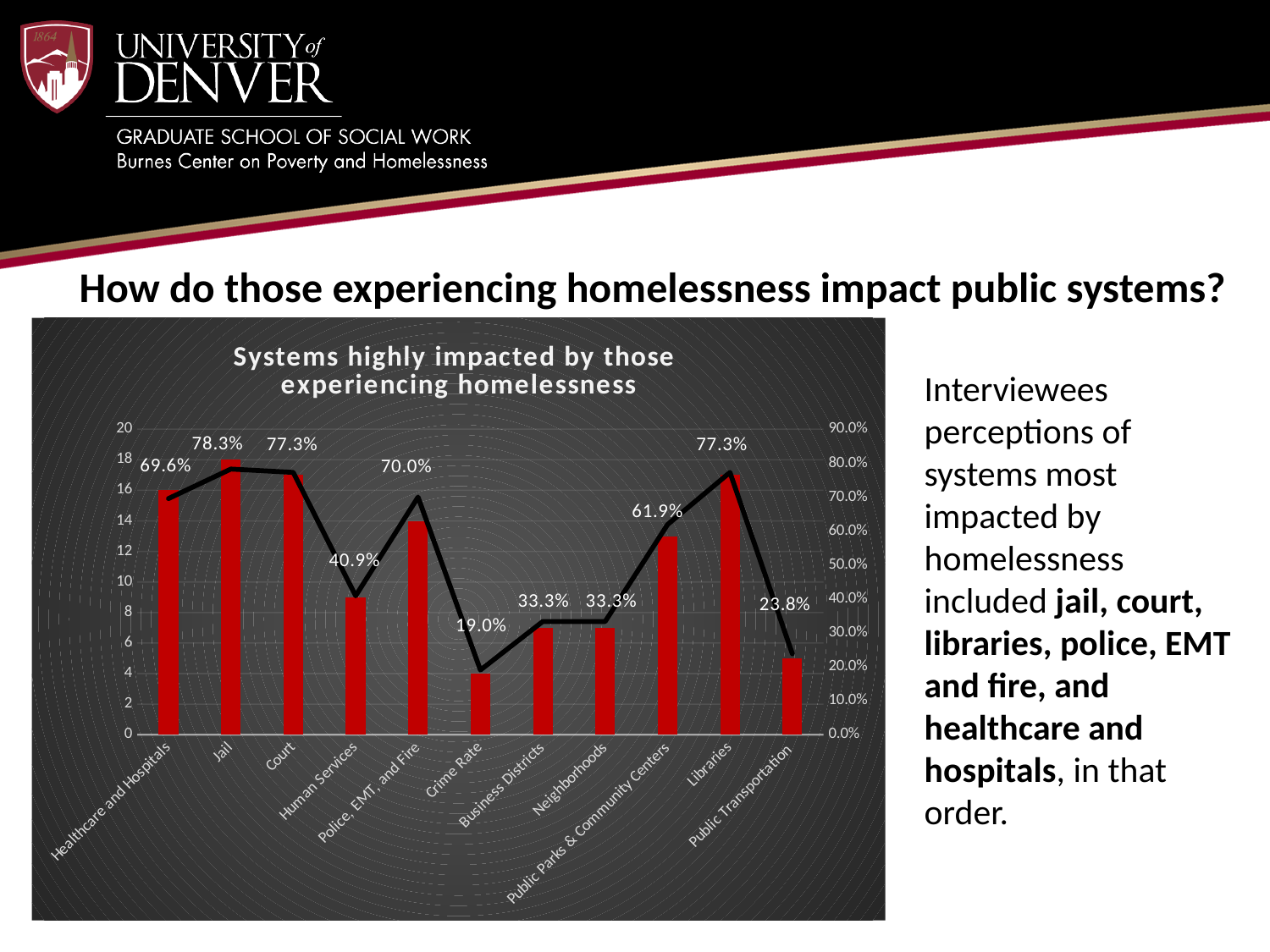
Which category has the lowest percentage? Crime Rate Which category has the highest percentage? Jail What percentage is shown for Jail? 78.3% What is the title of the chart? Systems highly impacted by those experiencing homelessness How many categories are shown on the x axis? 11 Which has a higher percentage, Police, EMT, and Fire or Healthcare and Hospitals? Police, EMT, and Fire What percentage is shown for Human Services? 40.9% What percentage is shown for Public Parks & Community Centers? 61.9% What is the difference between the percentages for Jail and Public Transportation? 54.5% Is the bar for Crime Rate on the left axis greater or less than 6? less What percentage is shown for Crime Rate? 19.0% Is the bar for Jail on the left axis greater or less than 16? greater